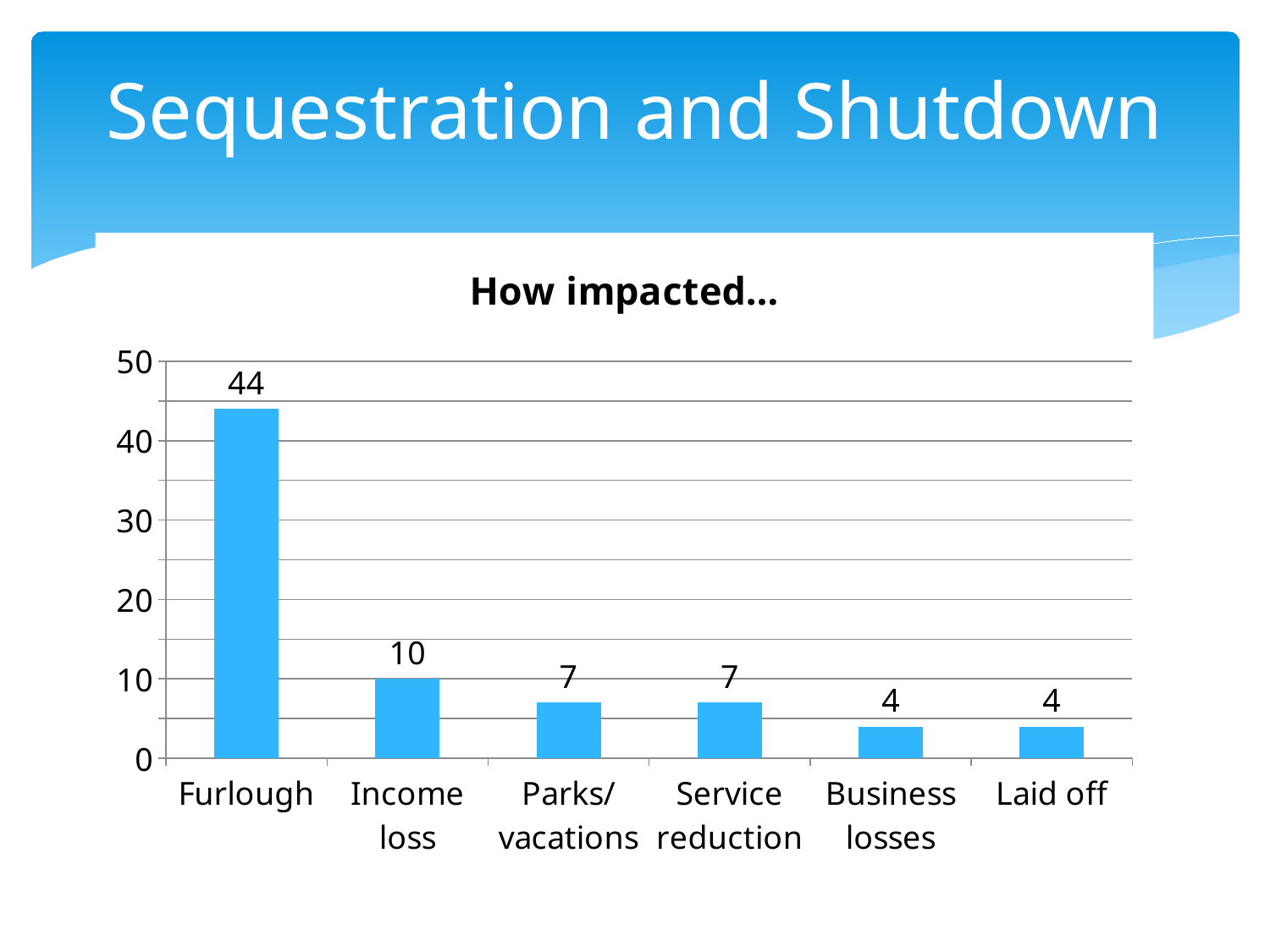
What kind of chart is shown on the slide? Bar chart What is the value for Laid off? 4 How many categories are shown on the x axis? 6 What is the difference between the values for Furlough and Income loss? 34 What is the value for Furlough? 44 Which is larger, the value for Income loss or the value for Service reduction? Income loss What is the value for Service reduction? 7 What is the title of the chart? How impacted… What is the difference between the values for Parks/vacations and Business losses? 3 Is the value for Furlough greater or less than 40? greater Which category has the highest value? Furlough What is the value for Income loss? 10